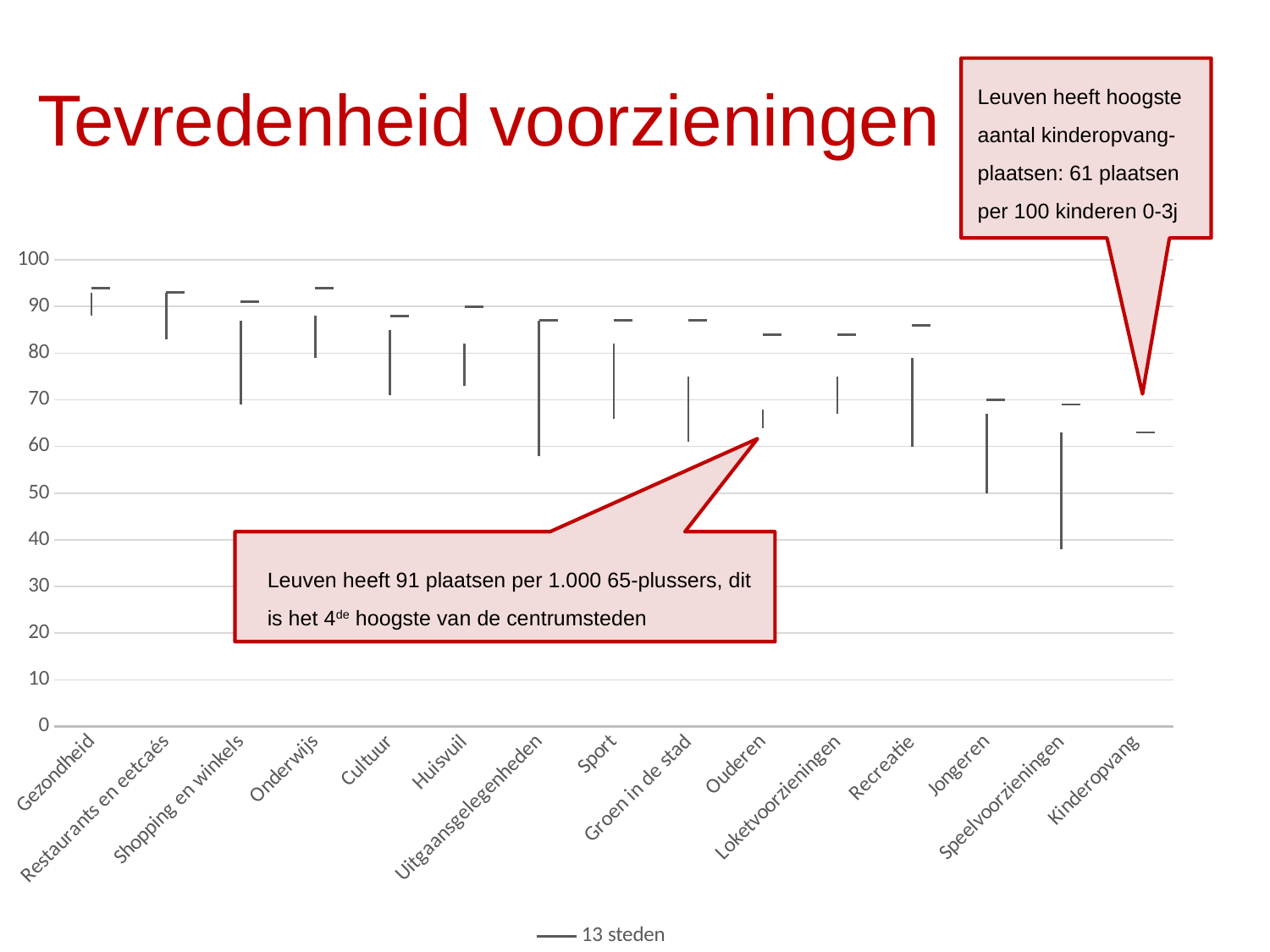
Is the top marker for Gezondheid greater or less than 90? greater Is the lowest point of the line for Speelvoorzieningen greater or less than 40? less What kind of chart is shown on the slide? stock chart (high-low chart) Is the marker for Kinderopvang greater or less than 70? less What entry does the chart's legend show? 13 steden Which category has the lowest point on the chart? Speelvoorzieningen How many categories are shown on the x axis of the chart? 15 What is the title of the slide containing the chart? Tevredenheid voorzieningen How many series does the legend list? 1 Do the top markers generally rise or fall from left to right along the x axis? fall